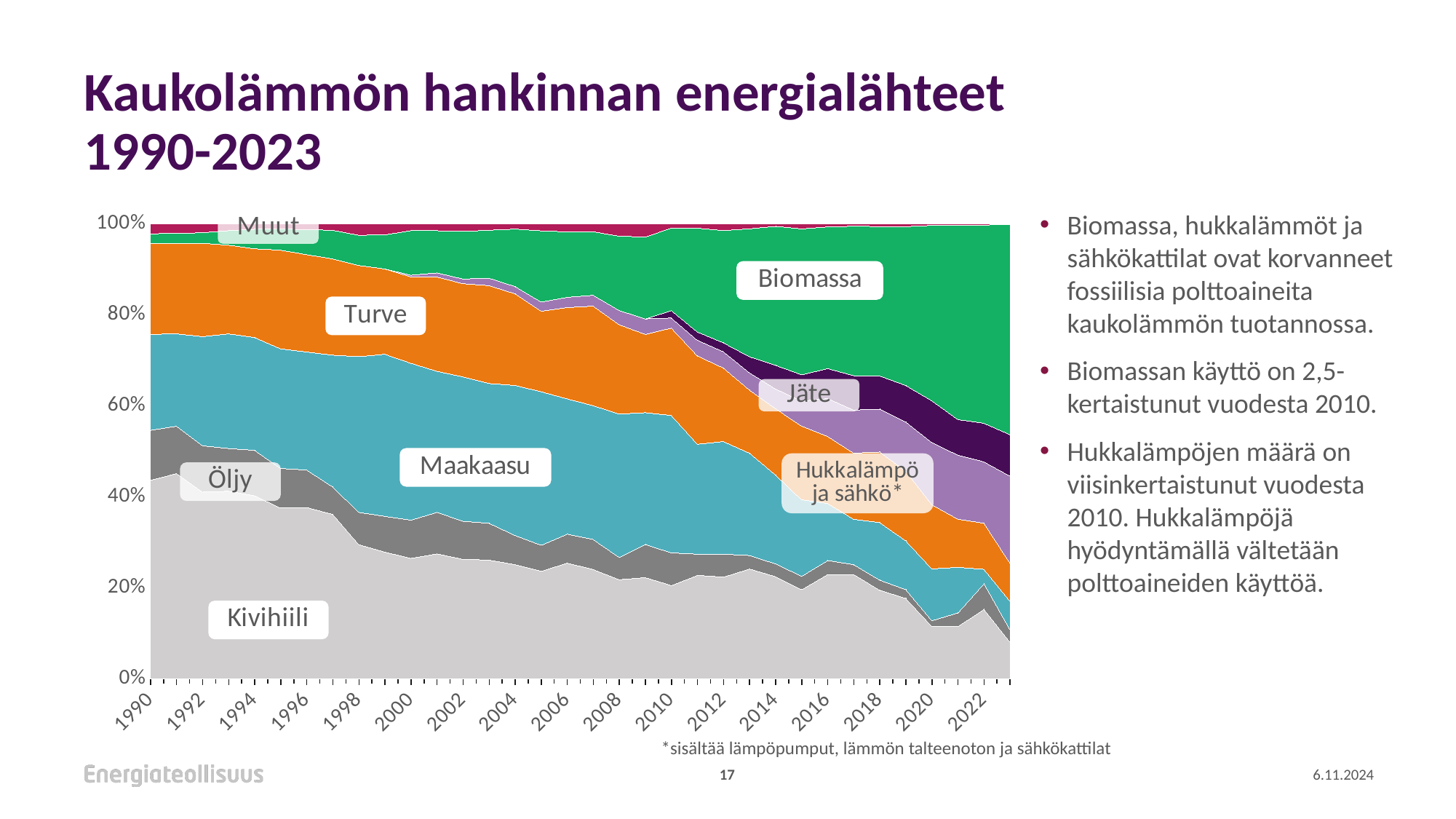
Is the share of Kivihiili in 2023 greater or less than 20%? less Does the share of Kivihiili rise or fall from 1990 to 2023? Fall How many energy source series are labelled in the chart? 8 What is the title of the chart on the slide? Kaukolämmön hankinnan energialähteet 1990-2023 What kind of chart is shown on the slide? Stacked area chart Which energy source has the largest share in 1990? Kivihiili Does the share of Biomassa rise or fall from 1990 to 2023? Rise Is the share of Kivihiili in 1990 greater or less than 40%? greater Does the share of Turve rise or fall from 1990 to 2023? Fall Which energy source has the largest share in 2023? Biomassa Which series is shown in green in the chart? Biomassa What is the first year shown on the x axis of the chart? 1990